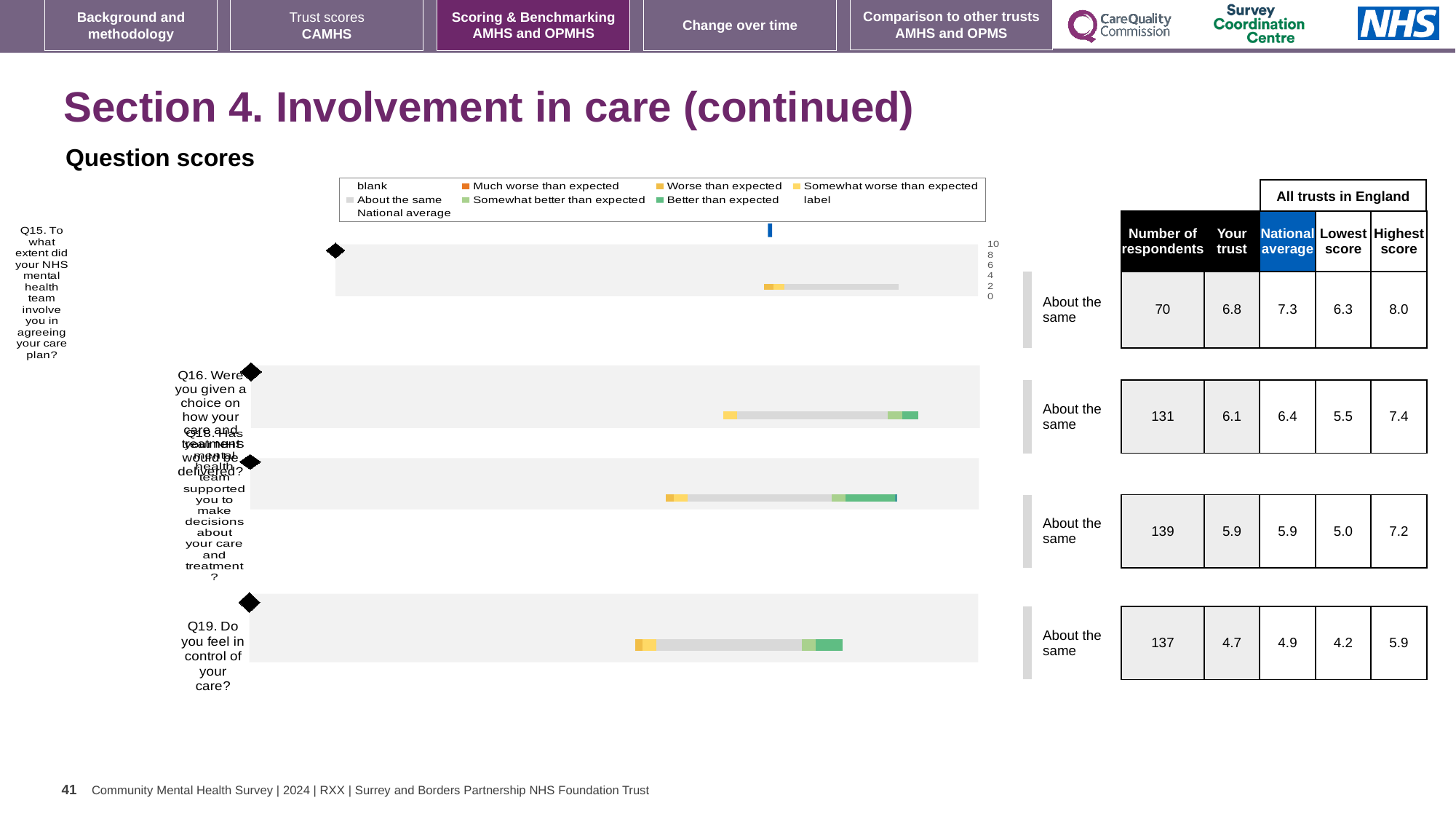
Which question has the highest 'Your trust' score? Q15 What benchmark category is shown for Q19? About the same For Q16, which is larger: the 'Your trust' score or the national average? National average How many respondents answered Q18? 139 For Q16, what is the difference between the highest score and the lowest score across all trusts in England? 1.9 What is the national average score for Q19 (Do you feel in control of your care?)? 4.9 Which question has the lowest 'Your trust' score? Q19 For Q15, how much higher is the national average than the 'Your trust' score? 0.5 What is the 'Your trust' score for Q15 (involving you in agreeing your care plan)? 6.8 What is the highest score among all trusts in England for Q18? 7.2 How many questions (categories) are plotted in the question scores chart? 4 What kind of chart is used to show the question scores? bar chart